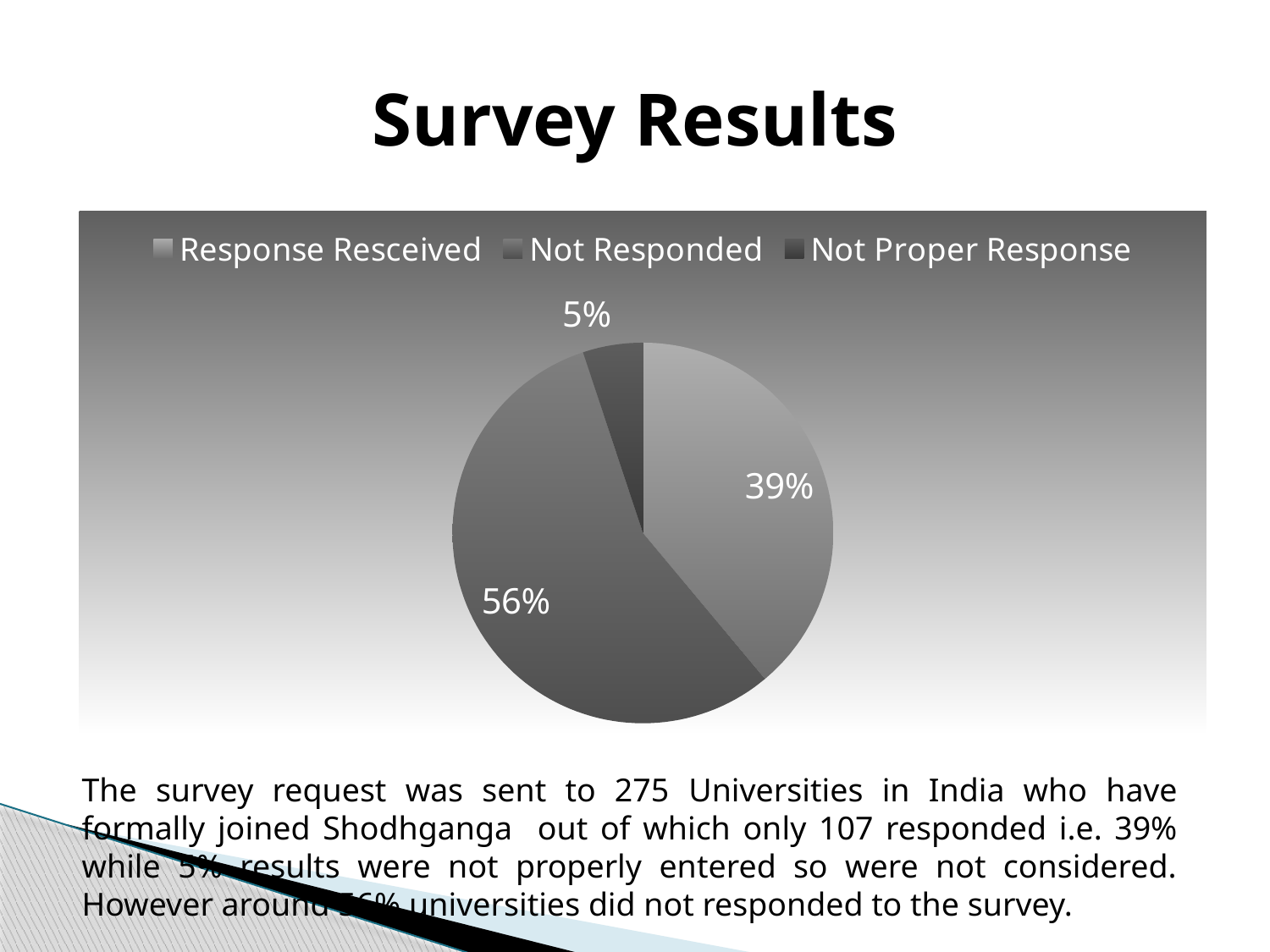
What is the difference in percentage points between Not Responded and Response Resceived? 17% What is the title of the slide containing the pie chart? Survey Results Which category has the largest slice of the pie? Not Responded What kind of chart is shown on the slide? Pie chart Which category has the smallest slice of the pie? Not Proper Response What share of the pie does Not Responded take? 56% What is the difference in percentage points between Response Resceived and Not Proper Response? 34% How many entries does the legend list? 3 What share of the pie does Not Proper Response take? 5% What share of the pie does Response Resceived take? 39% Which is larger, the slice for Response Resceived or the slice for Not Proper Response? Response Resceived How many slices does the pie chart have? 3